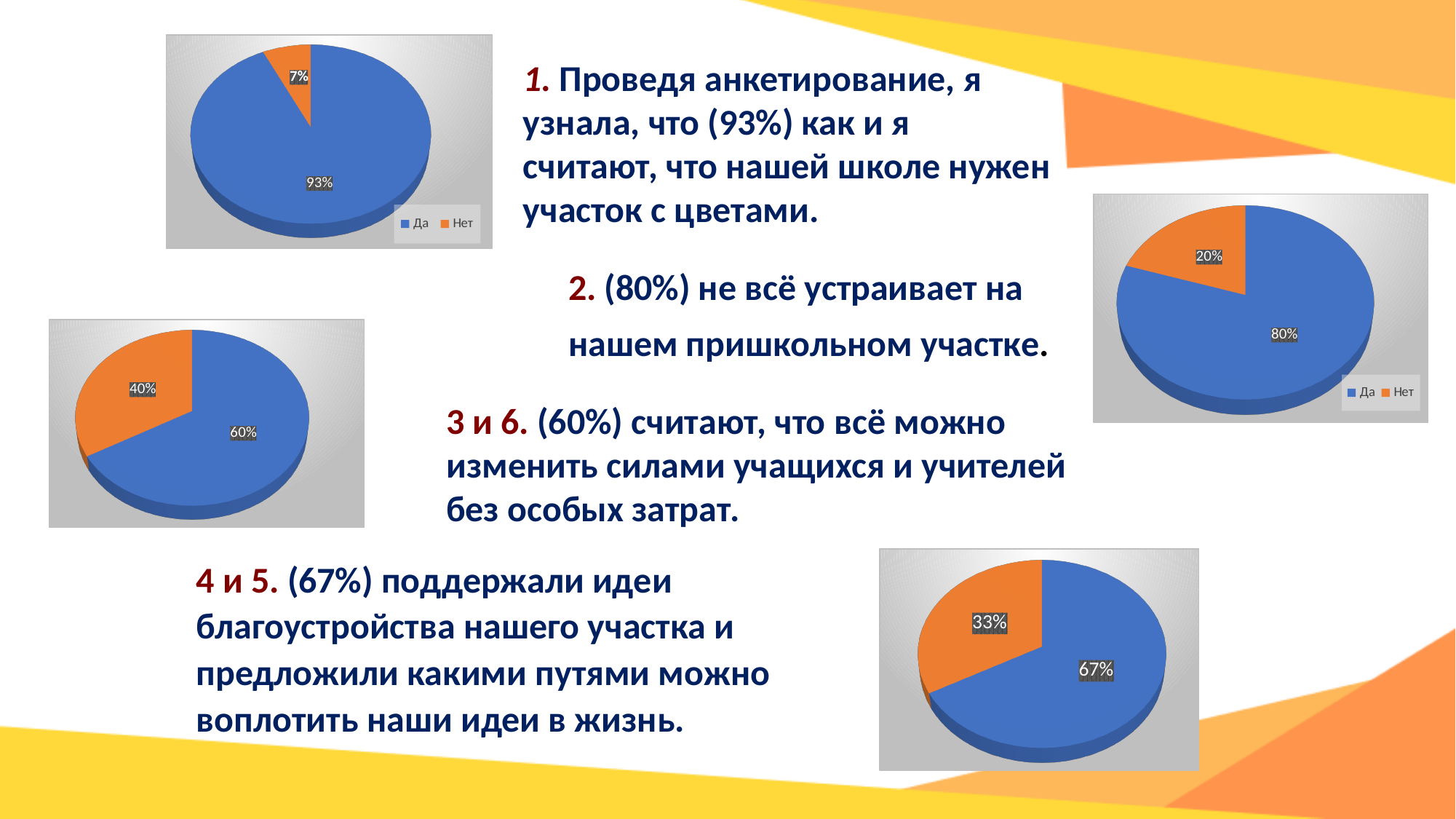
In the pie chart on the right side of the slide, what percentage is shown for "Нет"? 20% What type of chart is the top-left chart? Pie chart In the pie chart on the left side of the slide (middle), what percentage is shown for the orange slice? 40% In the bottom-right pie chart, what is the difference between the blue and orange slices? 34% In the top-left pie chart, what percentage is shown for the "Да" slice? 93% In the pie chart on the right side of the slide, which slice is larger, "Да" or "Нет"? Да In the top-left pie chart, what percentage is shown for the "Нет" slice? 7% In the bottom-right pie chart, what percentage is shown for the blue slice? 67% How many entries does the legend of the top-left pie chart list? 2 In the top-left pie chart, what is the difference between the "Да" and "Нет" percentages? 86% How many pie charts are shown on the slide? 4 In the pie chart on the right side of the slide, what percentage is shown for "Да"? 80%